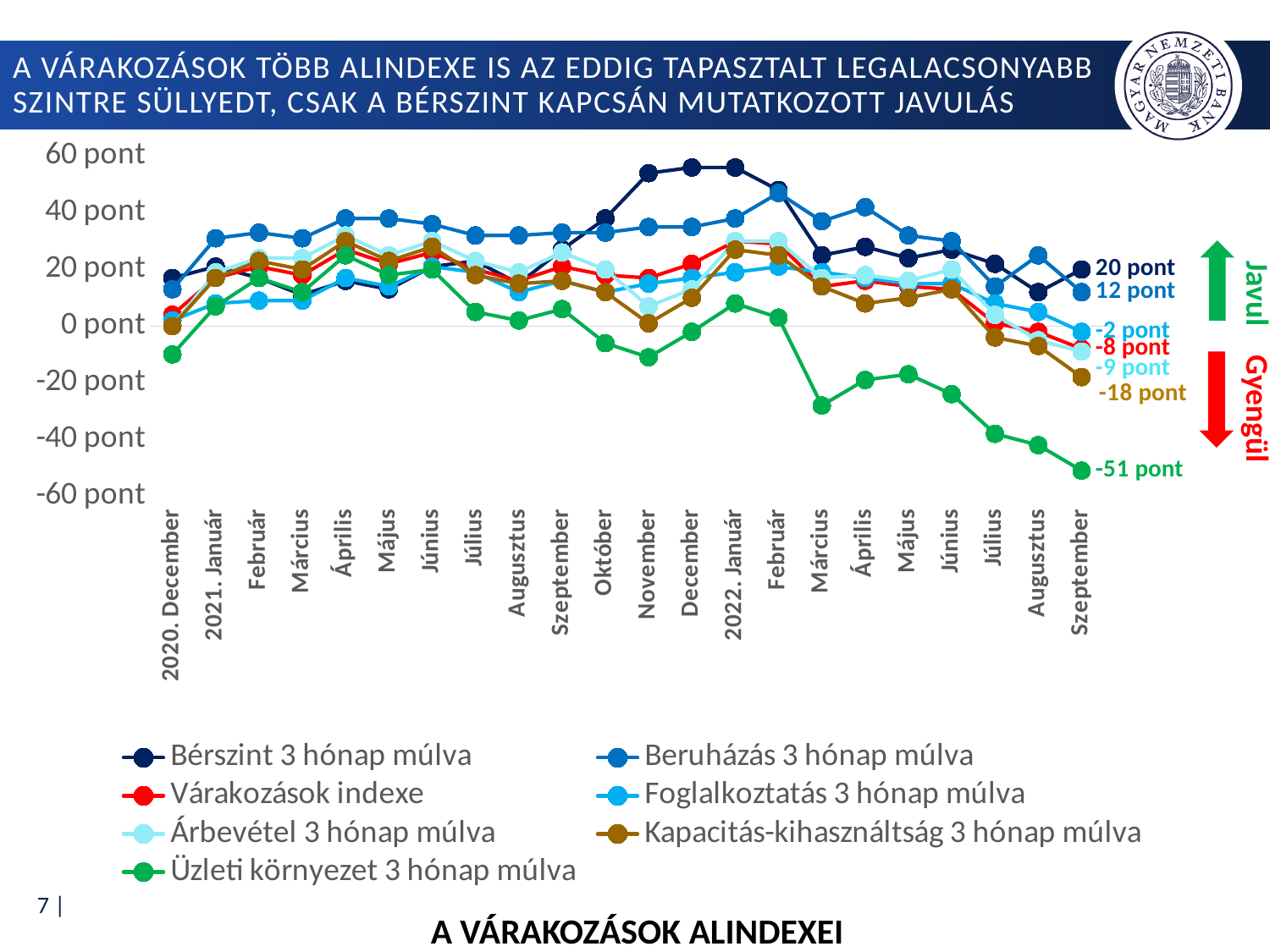
Does the Üzleti környezet 3 hónap múlva series rise or fall from Február (2022) to Szeptember? fall What kind of chart is shown on the slide? line chart Which series has the lowest value at the last point, Szeptember? Üzleti környezet 3 hónap múlva What is the value of Bérszint 3 hónap múlva in Szeptember (the last point)? 20 pont Is the value of Bérszint 3 hónap múlva in December (2021) greater or less than 40 pont? greater How many series does the legend list? 7 Is the value of Üzleti környezet 3 hónap múlva in Március (2022) greater or less than -20 pont? less At the last point (Szeptember), what is the difference between Bérszint 3 hónap múlva and Üzleti környezet 3 hónap múlva? 71 pont Which series has the highest value at the last point, Szeptember? Bérszint 3 hónap múlva What is the value of Üzleti környezet 3 hónap múlva in Szeptember (the last point)? -51 pont At the last point (Szeptember), which is larger: Beruházás 3 hónap múlva or Foglalkoztatás 3 hónap múlva? Beruházás 3 hónap múlva What is the value of Kapacitás-kihasználtság 3 hónap múlva at the last point, Szeptember? -18 pont